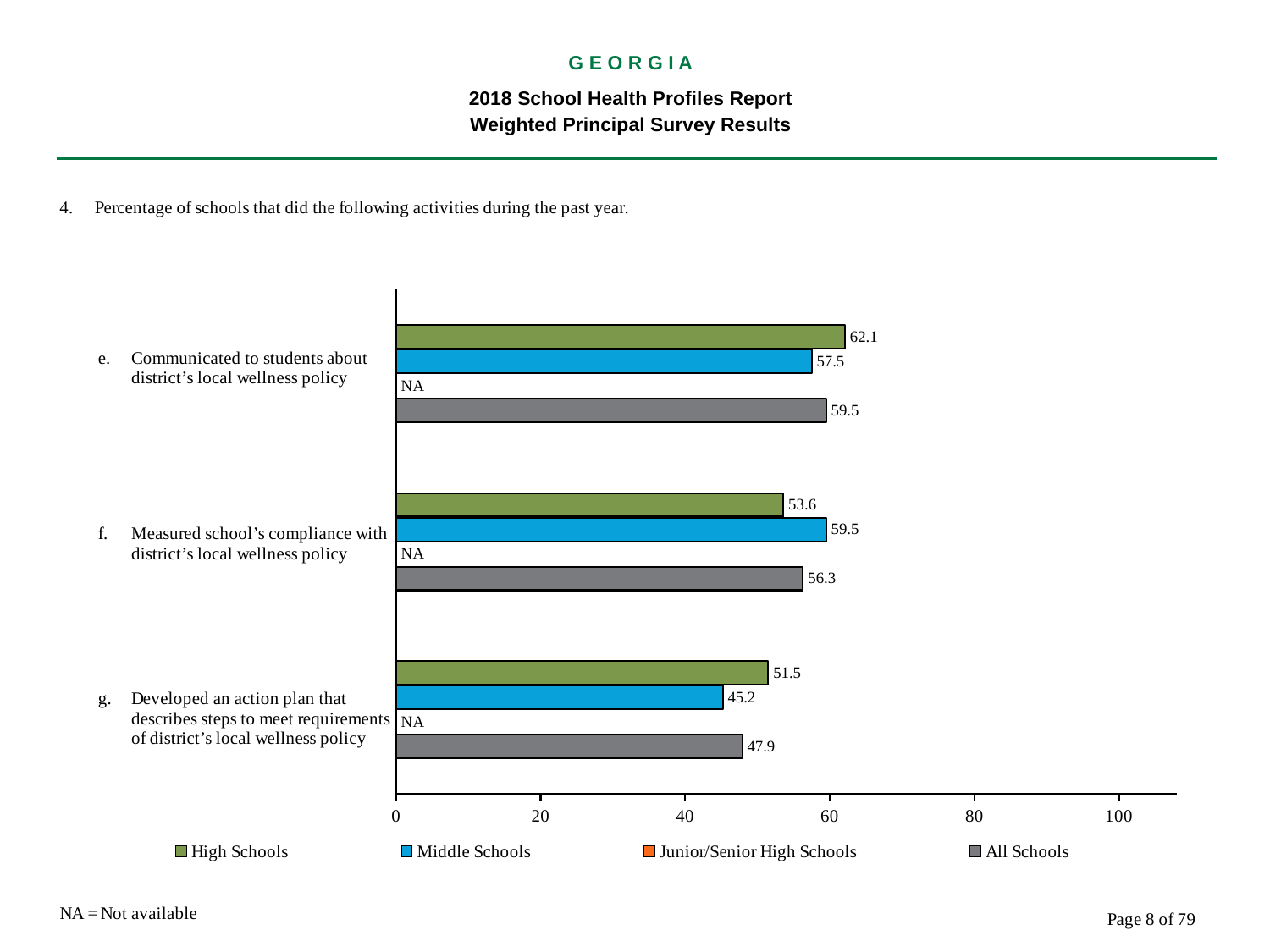
Which activity has the lowest All Schools value? Developed an action plan that describes steps to meet requirements of district's local wellness policy What is the High Schools value for 'Communicated to students about district's local wellness policy'? 62.1 What kind of chart is shown on the slide? Bar chart Is the All Schools value for 'Communicated to students about district's local wellness policy' greater or less than 40? greater For 'Measured school's compliance with district's local wellness policy', which is larger: the High Schools value or the Middle Schools value? Middle Schools How many series does the legend list? 4 Which activity has the highest High Schools value? Communicated to students about district's local wellness policy What is the difference between the High Schools and Middle Schools values for 'Developed an action plan that describes steps to meet requirements of district's local wellness policy'? 6.3 How many activities (categories) are shown on the chart? 3 What is shown for Junior/Senior High Schools for 'Communicated to students about district's local wellness policy'? NA What is the All Schools value for 'Measured school's compliance with district's local wellness policy'? 56.3 What is the Middle Schools value for 'Developed an action plan that describes steps to meet requirements of district's local wellness policy'? 45.2